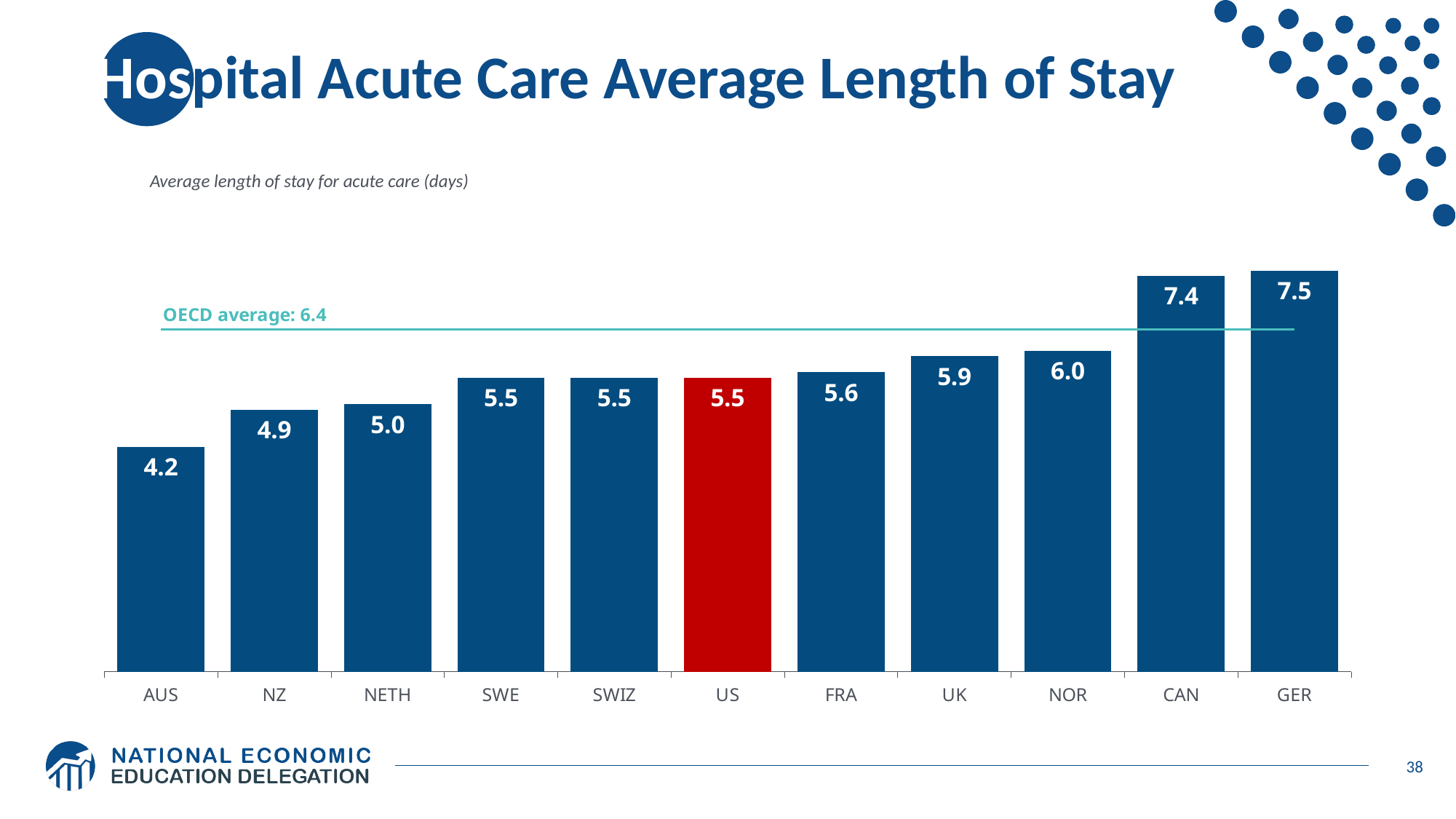
What is the difference between the values for NOR and NETH? 1.0 Which country has the highest average length of stay for acute care? GER What is the OECD average shown on the chart? 6.4 What is the average length of stay for acute care in Germany (GER)? 7.5 What kind of chart is shown on the slide? Bar chart What is the value shown for AUS? 4.2 How many countries are shown on the chart? 11 Which country has the lowest average length of stay for acute care? AUS What is the average length of stay for acute care in the US? 5.5 Which country's bar is coloured red? US What is the difference between the values for CAN and AUS? 3.2 Which has a higher average length of stay, UK or NZ? UK